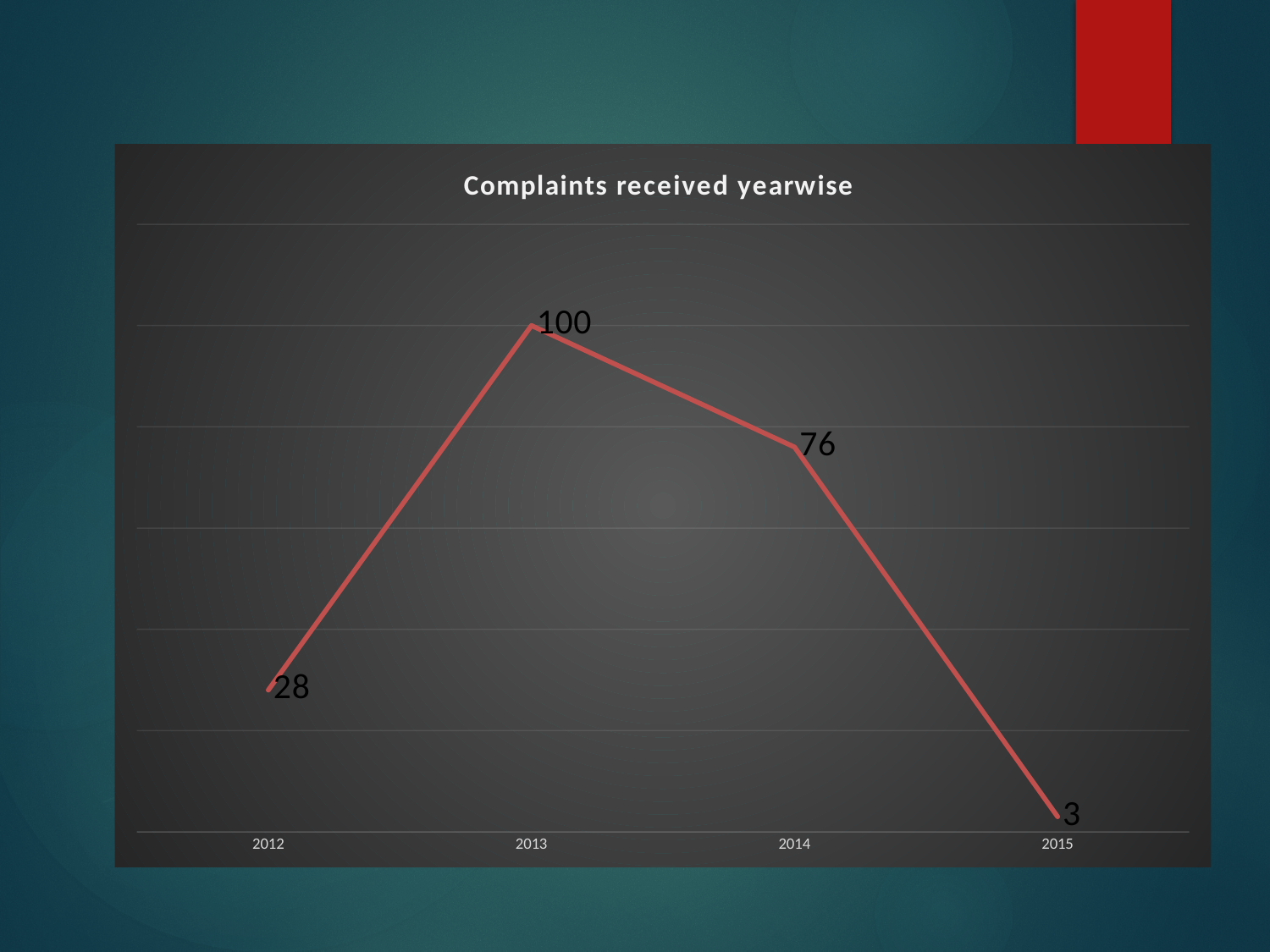
What is the value for 2013? 100 What kind of chart is shown? line chart How many years are plotted on the chart? 4 Which year has the lowest number of complaints? 2015 What is the value for 2015? 3 What is the value for 2012? 28 What is the difference between the values for 2012 and 2015? 25 What is the difference between the values for 2013 and 2014? 24 What is the value for 2014? 76 What is the title of the chart? Complaints received yearwise Which is larger, the value for 2012 or the value for 2014? 2014 Which year has the highest number of complaints? 2013